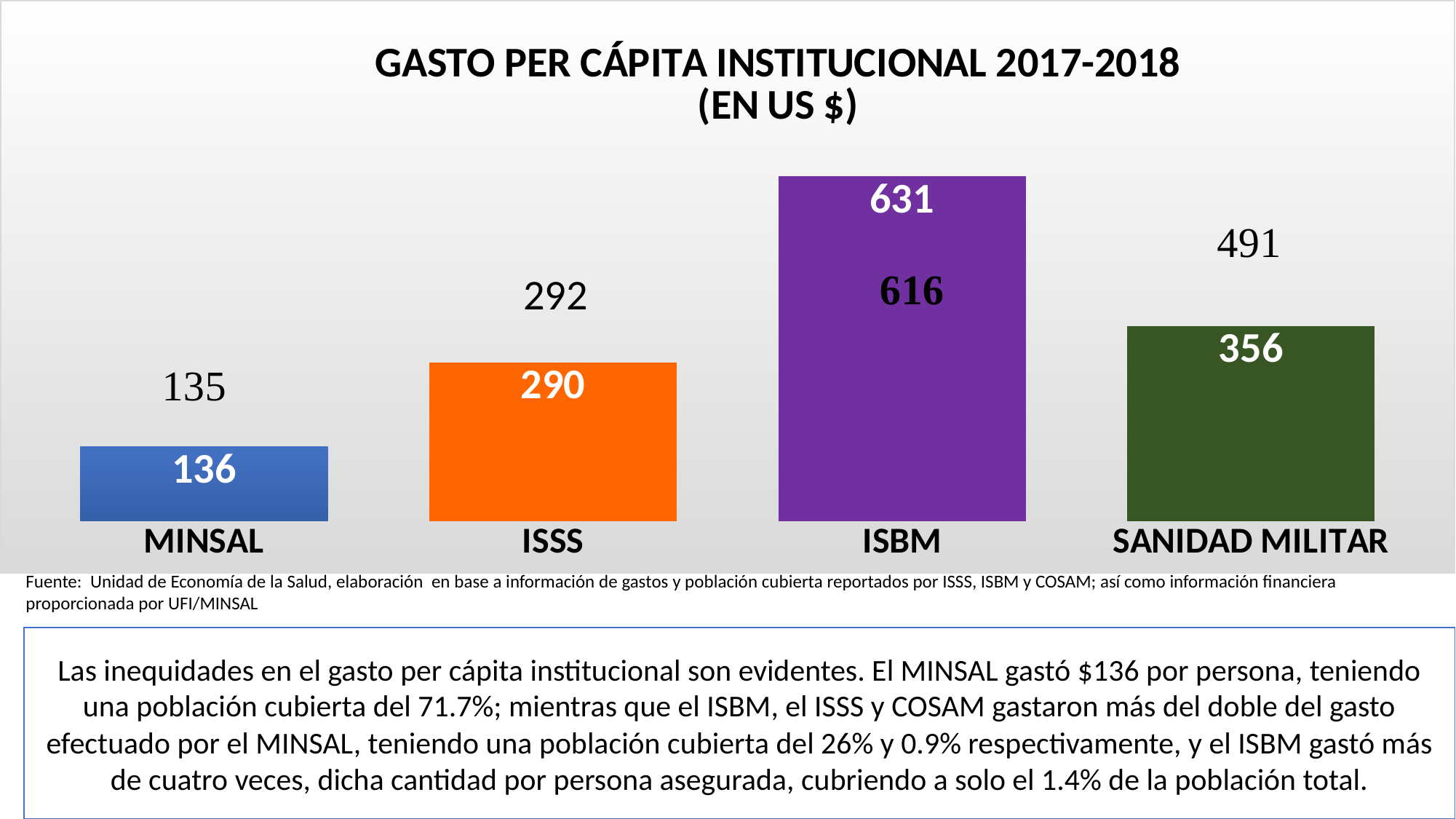
Is the bar for ISSS taller or shorter than the bar for SANIDAD MILITAR? shorter What value is printed inside the bar for SANIDAD MILITAR? 356 What kind of chart is shown on the slide? bar chart What value is printed inside the bar for MINSAL? 136 How many institutions (categories) are shown on the x axis of the chart? 4 Based on the values printed inside the bars, what is the difference between ISBM (631) and MINSAL (136)? 495 What is the title of the chart? GASTO PER CÁPITA INSTITUCIONAL 2017-2018 (EN US $) Which institution has the tallest bar in the chart? ISBM What value is printed in black above the SANIDAD MILITAR bar? 491 What value is printed inside the bar for ISSS? 290 What value is printed in black above the ISSS bar? 292 Which institution has the shortest bar in the chart? MINSAL